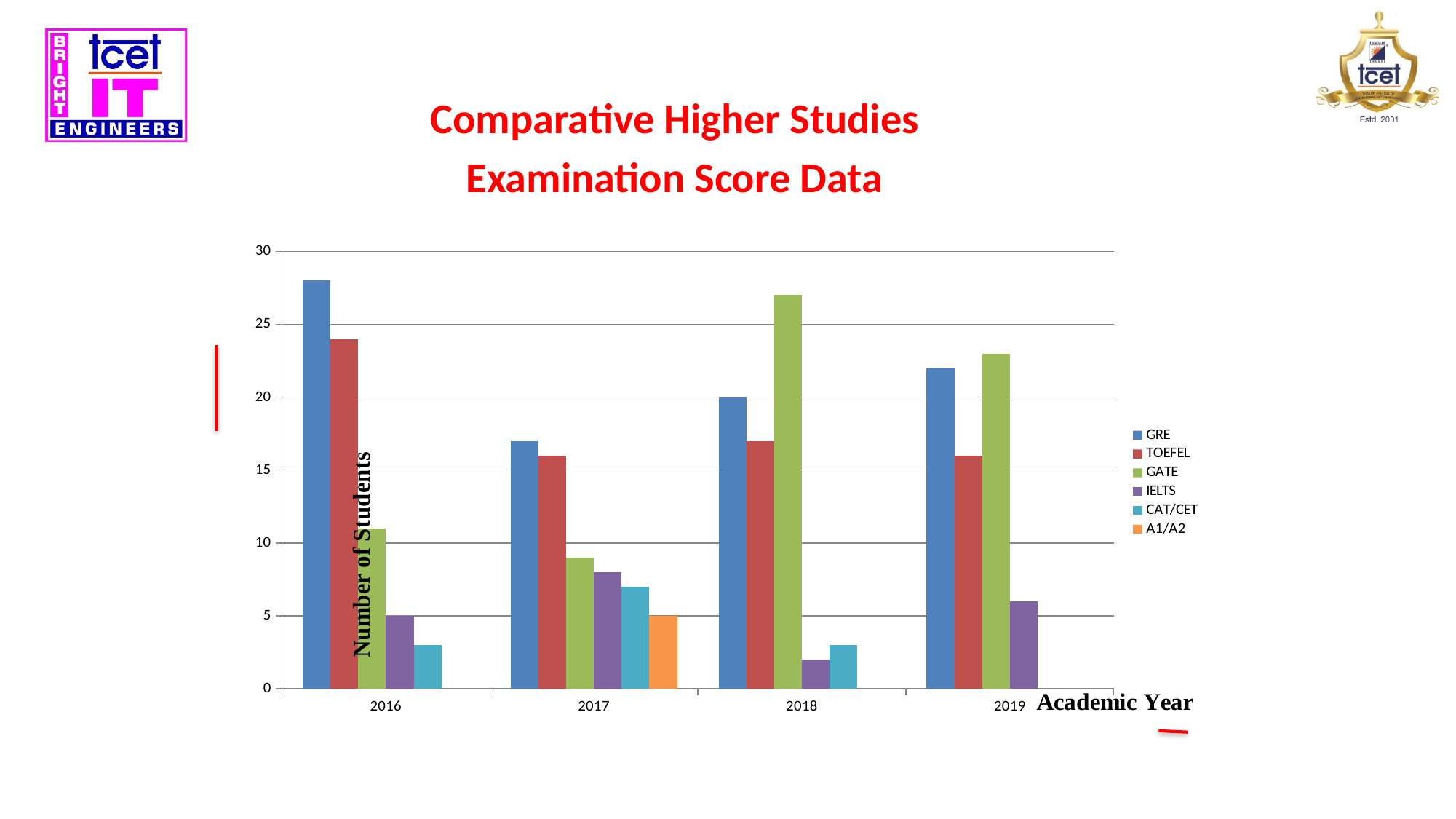
Is the value for TOEFEL in 2019 greater or less than 20? less How many academic years are shown on the x axis? 4 How many series does the legend list? 6 Is the value for GATE in 2018 greater or less than 25? greater Is the value for GRE in 2016 greater or less than 25? greater Does the value for GRE rise or fall from 2016 to 2017? fall In 2016, which is larger, GRE or TOEFEL? GRE Which series has the highest value in 2018? GATE What kind of chart is shown on the slide? bar chart What is the label on the x axis? Academic Year